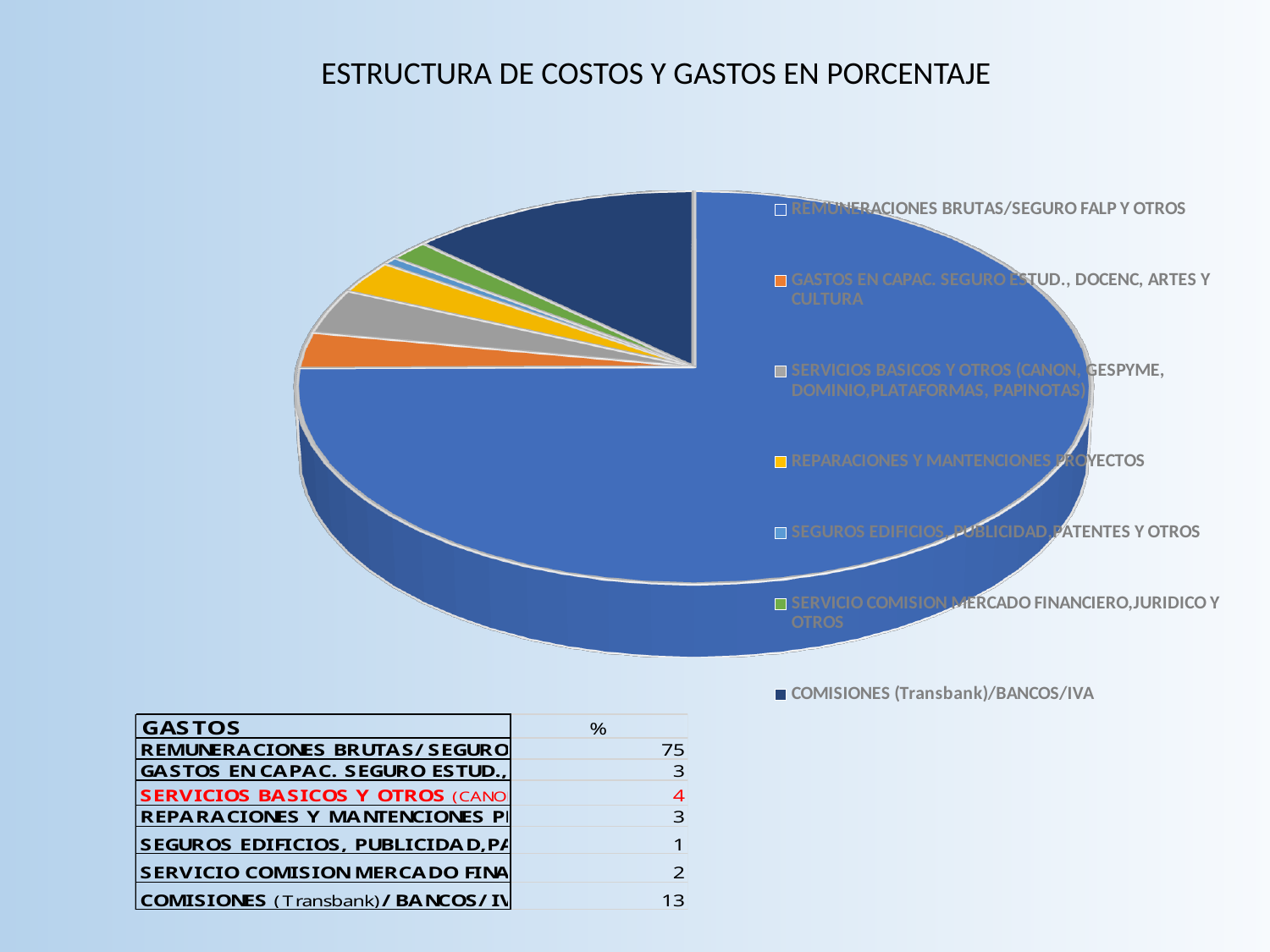
How many entries does the chart legend list? 7 According to the table, what percentage corresponds to COMISIONES (Transbank)/BANCOS/IVA? 13 According to the table, what percentage corresponds to REMUNERACIONES BRUTAS/SEGURO? 75 What is the difference in percentage points between REMUNERACIONES BRUTAS/SEGURO and COMISIONES (Transbank)/BANCOS/IVA? 62 How many slices does the pie chart have? 7 According to the table, what percentage corresponds to SERVICIOS BASICOS Y OTROS? 4 According to the table, what percentage corresponds to SEGUROS EDIFICIOS, PUBLICIDAD? 1 What kind of chart is shown on the slide? pie chart What is the title of the slide's chart? ESTRUCTURA DE COSTOS Y GASTOS EN PORCENTAJE Which category has the smallest share of the pie? SEGUROS EDIFICIOS, PUBLICIDAD, PATENTES Y OTROS Which category has the largest share of the pie? REMUNERACIONES BRUTAS/SEGURO FALP Y OTROS Which is larger, the share for SERVICIOS BASICOS Y OTROS or the share for SERVICIO COMISION MERCADO FINANCIERO? SERVICIOS BASICOS Y OTROS